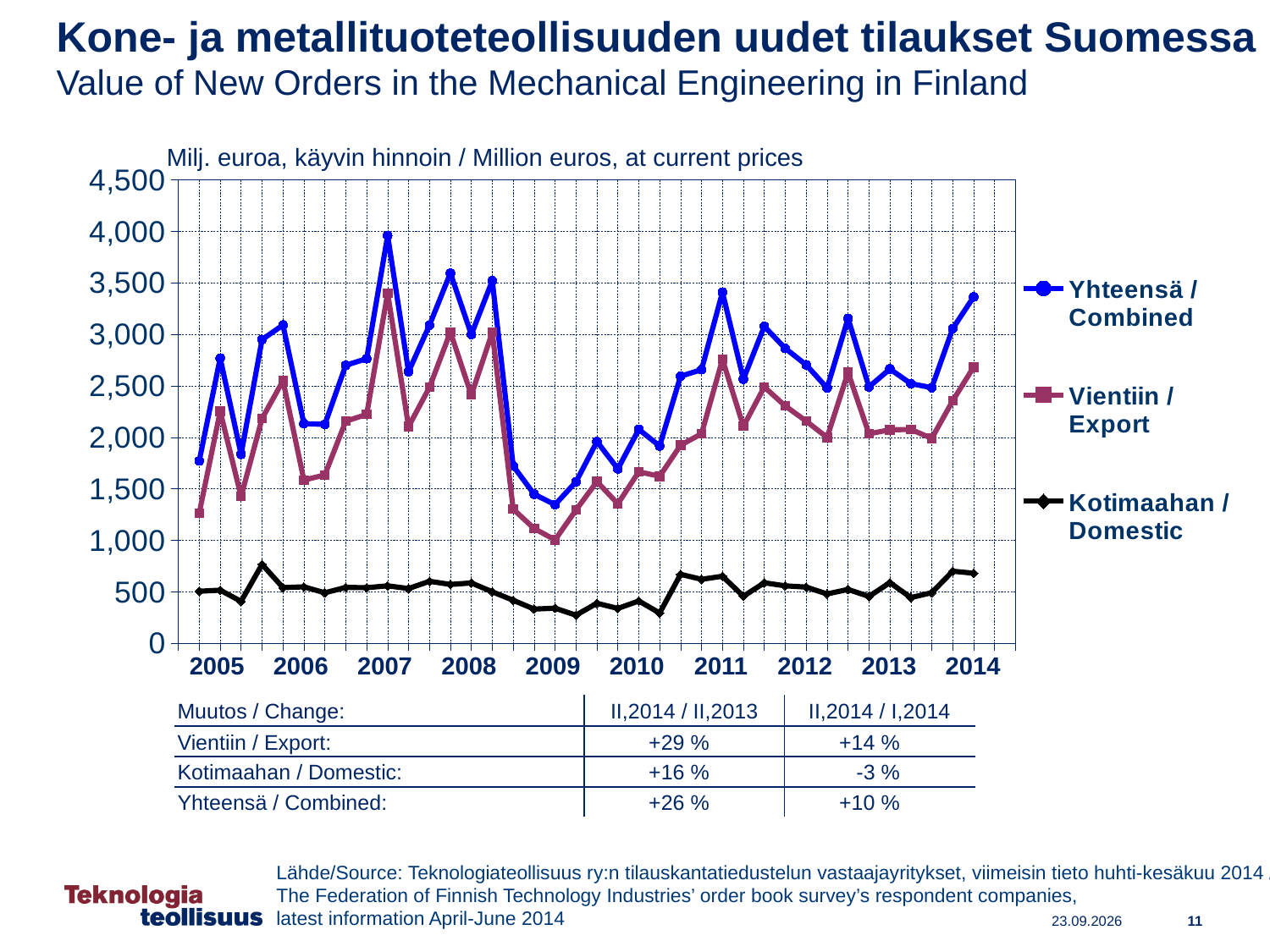
Does the Vientiin / Export series rise or fall between 2013 and 2014? rise How many year labels are shown on the x axis? 10 What unit is stated above the chart for the plotted values? Milj. euroa, käyvin hinnoin / Million euros, at current prices How many series does the legend list? 3 Is the last plotted value of the Yhteensä / Combined series in 2014 greater or less than 3,000? greater Which series has the highest values throughout the chart? Yhteensä / Combined Which series has the lowest values throughout the chart? Kotimaahan / Domestic Is the highest value of the Kotimaahan / Domestic series greater or less than 1,000? less Is the peak value of the Yhteensä / Combined series in 2007 greater or less than 3,500? greater Does the Yhteensä / Combined series rise or fall between 2008 and 2009? fall What kind of chart is shown on the slide? line chart